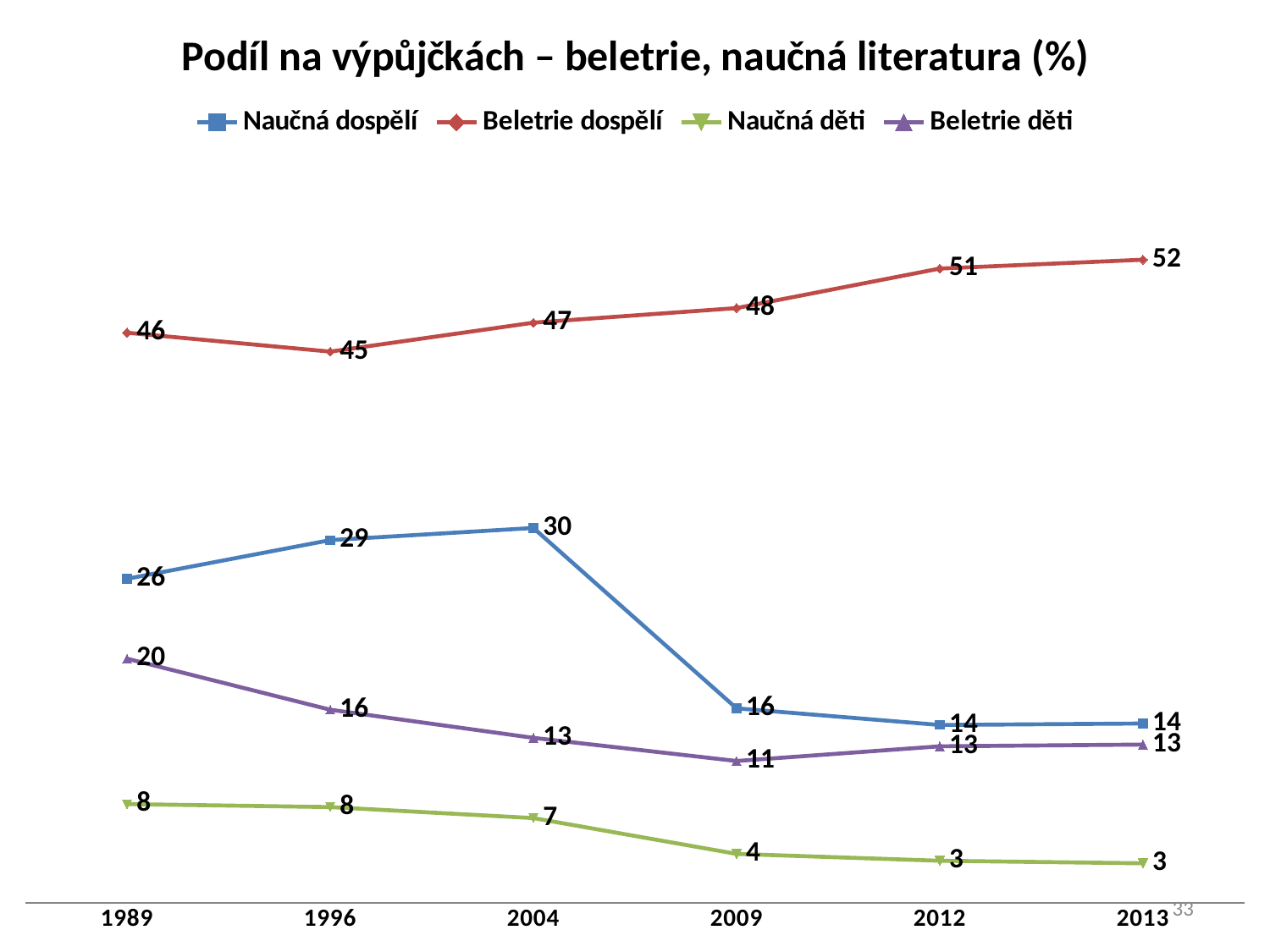
How many years are shown on the x axis? 6 What is the value for Beletrie děti in 1989? 20 What is the difference between Naučná dospělí in 2004 and in 2009? 14 What kind of chart is this? line chart What is the value for Naučná děti in 2009? 4 Does the Naučná děti series rise or fall from 1989 to 2013? fall Which is larger in 2012: Naučná dospělí or Beletrie děti? Naučná dospělí In which year is Beletrie dospělí at its lowest? 1996 How many series does the legend list? 4 What is the value for Naučná dospělí in 2004? 30 In which year is Naučná dospělí at its highest? 2004 What is the value for Beletrie dospělí in 2013? 52